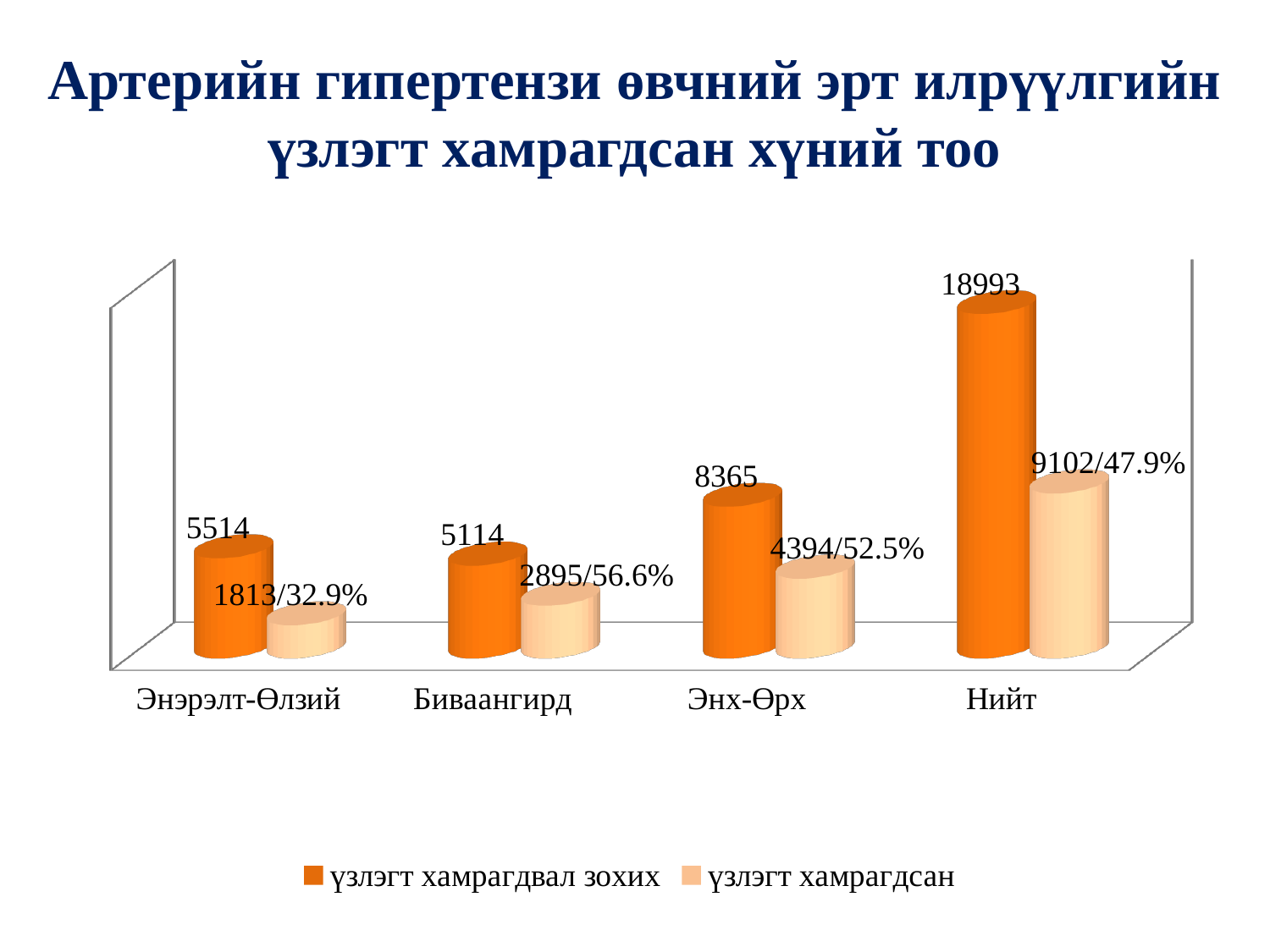
What kind of chart is shown on the slide? Bar chart What is the value of the 'үзлэгт хамрагдвал зохих' series for Энх-Өрх? 8365 How many series does the legend list? 2 What is the difference between the 'үзлэгт хамрагдвал зохих' values for Энэрэлт-Өлзий and Биваангирд? 400 What is the value of the 'үзлэгт хамрагдвал зохих' series for Нийт? 18993 For Нийт, what is the difference between the 'үзлэгт хамрагдвал зохих' value (18993) and the 'үзлэгт хамрагдсан' count (9102)? 9891 Which is larger: the 'үзлэгт хамрагдсан' count for Энх-Өрх or for Биваангирд? Энх-Өрх How many categories are shown on the x axis? 4 What data label is shown for the 'үзлэгт хамрагдсан' series for Биваангирд? 2895/56.6% Which category has the highest value for the 'үзлэгт хамрагдсан' series? Нийт Which category has the lowest value for the 'үзлэгт хамрагдвал зохих' series? Биваангирд What data label is shown for the 'үзлэгт хамрагдсан' series for Энэрэлт-Өлзий? 1813/32.9%